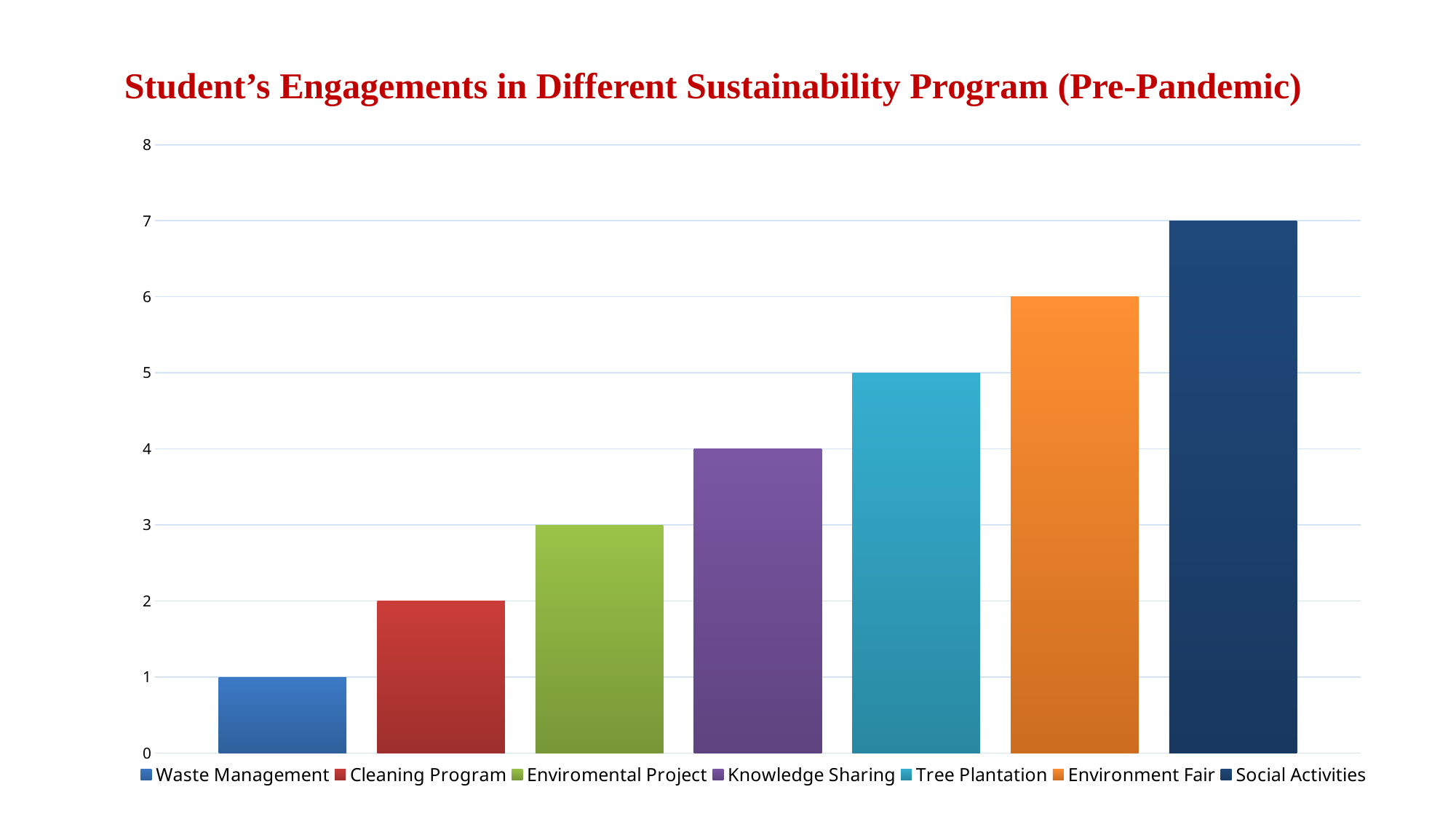
What is the value for Cleaning Program? 2 How many bars are shown in the chart? 7 Do the values rise or fall from left to right across the categories? Rise What kind of chart is shown on the slide? Bar chart What is the value for Knowledge Sharing? 4 What is the difference between the values for Social Activities and Waste Management? 6 Which category has the lowest value? Waste Management How many entries does the legend list? 7 What is the difference between the values for Environment Fair and Tree Plantation? 1 What is the value for Social Activities? 7 Which is larger, the value for Enviromental Project or the value for Tree Plantation? Tree Plantation Which category has the highest value? Social Activities